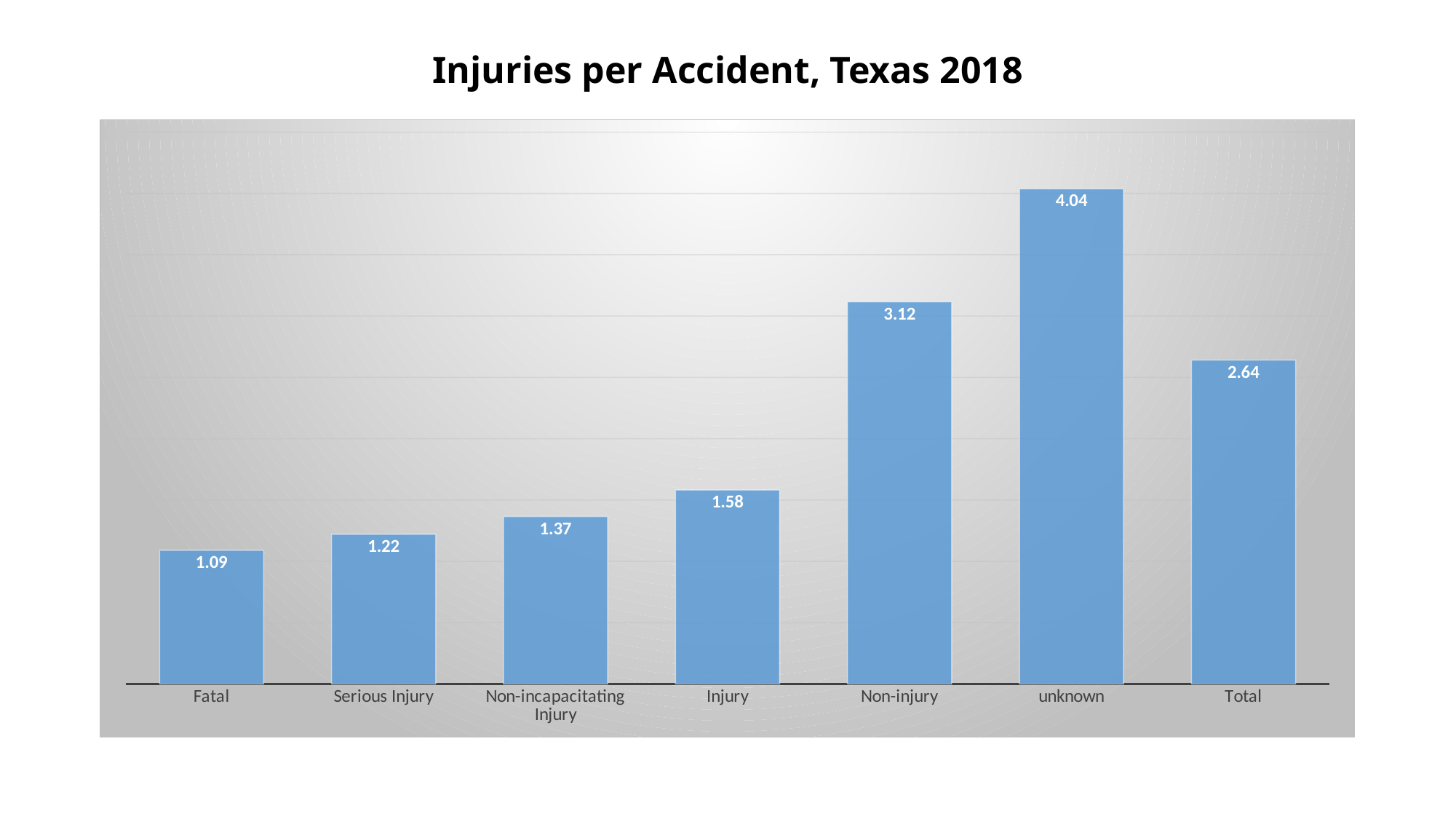
What is the value for Fatal? 1.09 What is the difference between the values for Injury and Serious Injury? 0.36 What is the value for Non-incapacitating Injury? 1.37 What is the value for Non-injury? 3.12 Which is larger, the value for Total or the value for Injury? Total How many categories are shown on the x axis? 7 What is the title of the chart? Injuries per Accident, Texas 2018 Which category has the highest value? unknown What is the value for Total? 2.64 What is the difference between the values for unknown and Non-injury? 0.92 Which category has the lowest value? Fatal What kind of chart is this? bar chart